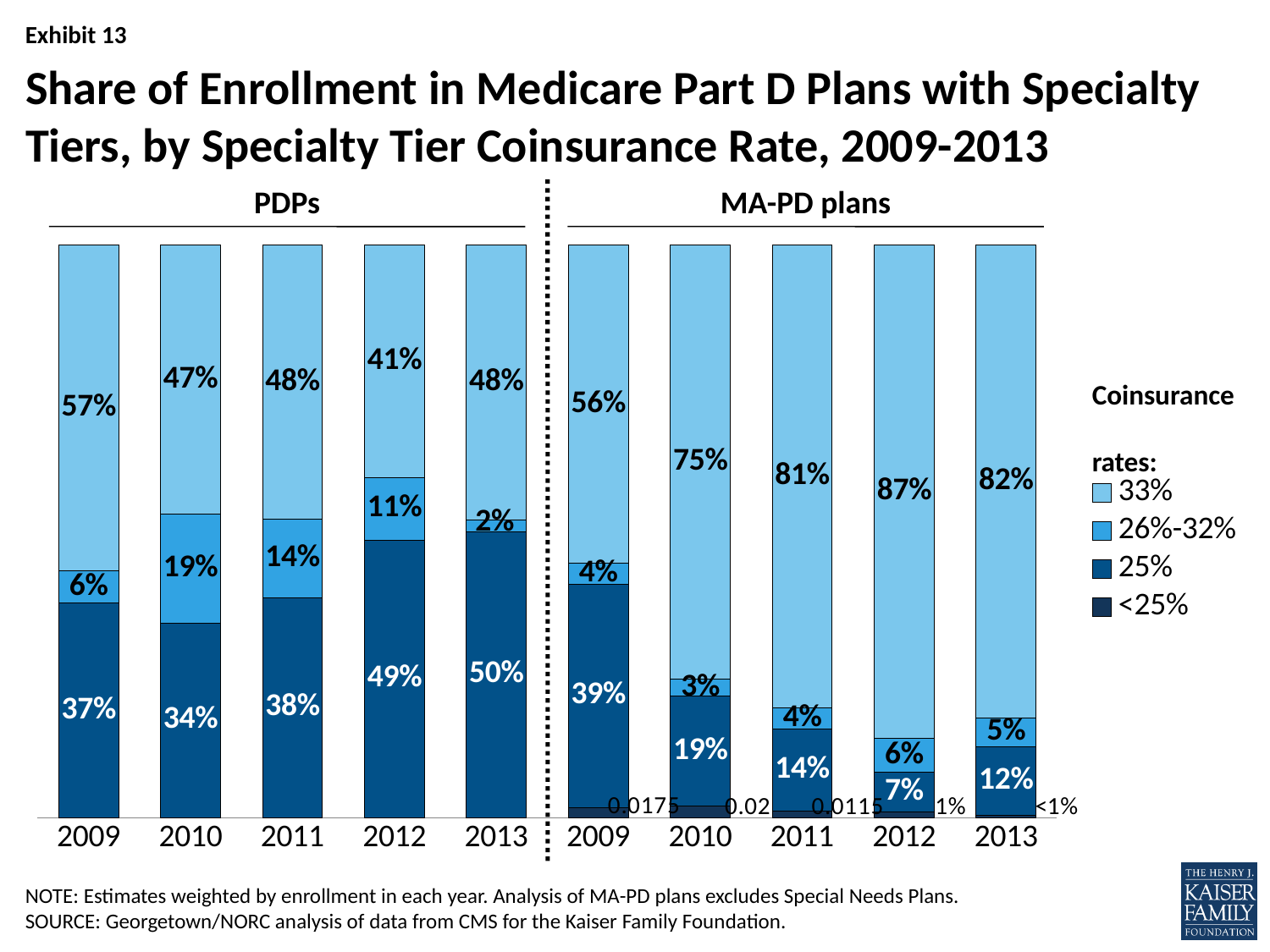
Among the MA-PD plan years, which year has the highest share of enrollment in plans with a 33% coinsurance rate? 2012 What kind of chart is shown on the slide? Stacked bar chart For MA-PD plans in 2012, what share of enrollment was in plans with a 33% coinsurance rate? 87% What share of PDP enrollment in 2013 was in plans with a 25% coinsurance rate? 50% Among the PDP years, which year has the lowest share of enrollment in plans with a 33% coinsurance rate? 2012 For MA-PD plans, by how many percentage points did the 33% coinsurance share increase from 2009 to 2012? 31 percentage points What share of PDP enrollment in 2009 was in plans with a 33% specialty tier coinsurance rate? 57% For PDPs, does the share of enrollment in plans with a 25% coinsurance rate rise or fall from 2011 to 2013? Rise For MA-PD plans in 2010, what share of enrollment was in plans with a 25% coinsurance rate? 19% For PDPs, how many percentage points higher is the 33% coinsurance share in 2009 than in 2013? 9 percentage points How many coinsurance rate categories does the legend list? 4 For PDPs, is the 26%-32% coinsurance share larger in 2011 or in 2012? 2011